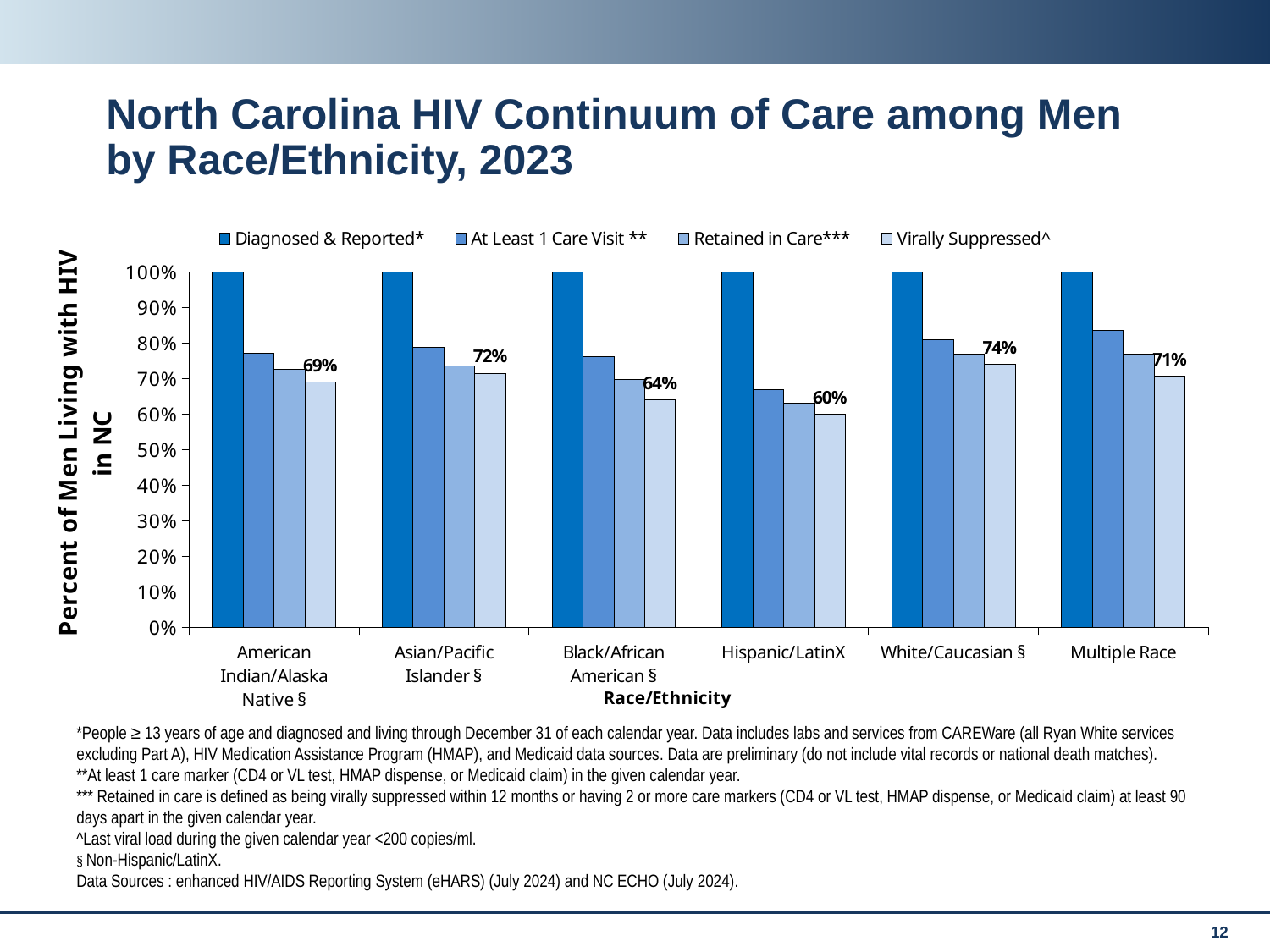
Which race/ethnicity group has the highest Virally Suppressed^ percentage? White/Caucasian § What is the difference between the Virally Suppressed^ values for White/Caucasian § and Hispanic/LatinX men? 14% What kind of chart is shown on the slide? Bar chart What is the Virally Suppressed^ value for Hispanic/LatinX men? 60% How many series does the legend list? 4 Which is larger, the Virally Suppressed^ value for Asian/Pacific Islander § or for American Indian/Alaska Native §? Asian/Pacific Islander § What is the Virally Suppressed^ value for Black/African American § men? 64% Is the At Least 1 Care Visit ** value for Hispanic/LatinX men greater or less than 70%? less Is the At Least 1 Care Visit ** value for Multiple Race men greater or less than 80%? greater How many race/ethnicity categories are shown on the x axis? 6 What is the Virally Suppressed^ value for White/Caucasian § men? 74% Which race/ethnicity group has the lowest Virally Suppressed^ percentage? Hispanic/LatinX